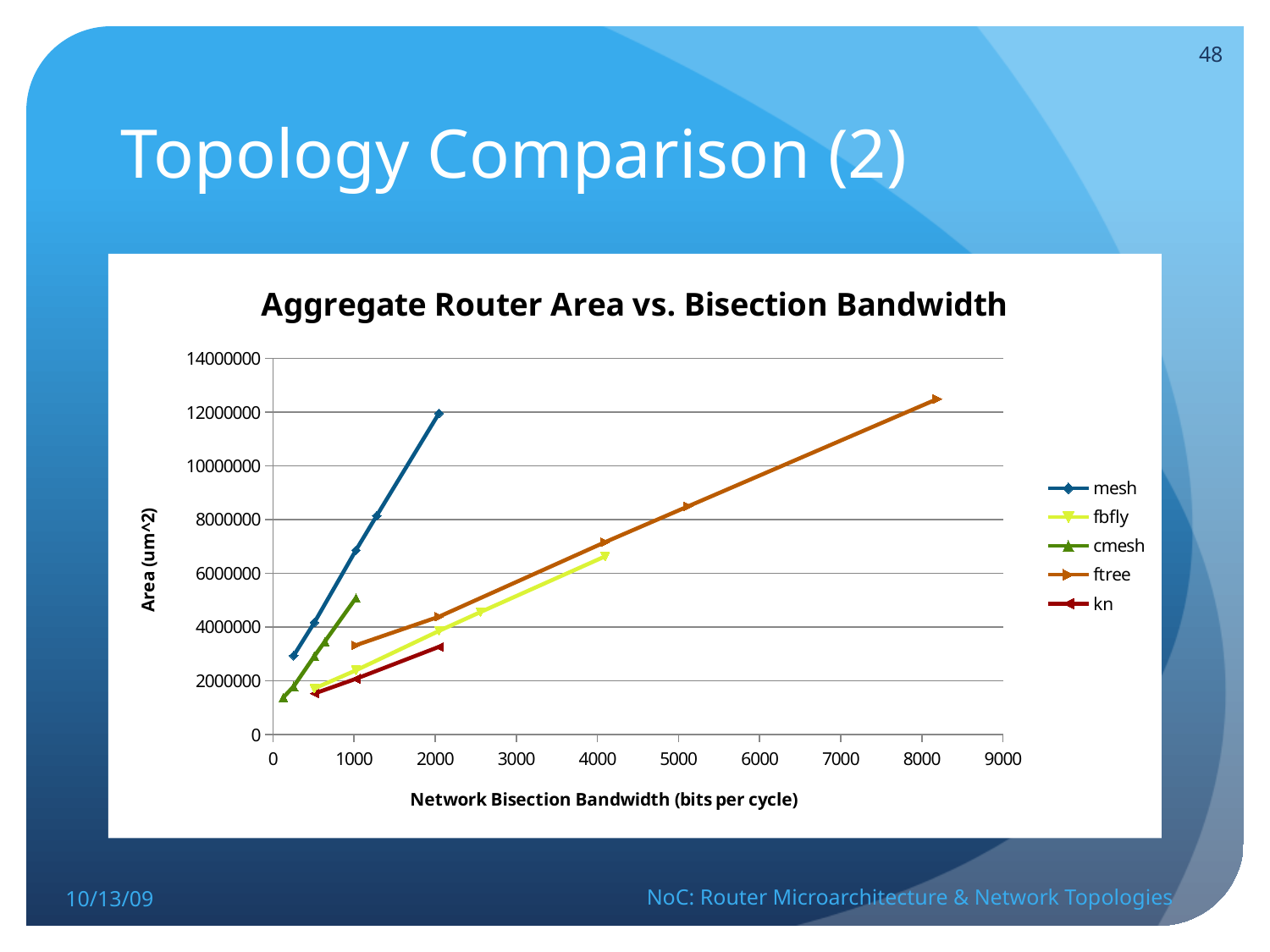
Which series reaches the lowest maximum area? kn Does the area for the mesh series rise or fall as bisection bandwidth increases? rise Is the highest area value for the mesh series greater or less than 10000000? greater Is the highest area value for the kn series greater or less than 4000000? less Is the highest area value for the cmesh series greater or less than 4000000? greater How many series does the legend list? 5 What is the label of the x axis? Network Bisection Bandwidth (bits per cycle) What is the title of the chart? Aggregate Router Area vs. Bisection Bandwidth Which series extends furthest along the x axis (highest bisection bandwidth)? ftree What kind of chart is shown on the slide? line chart